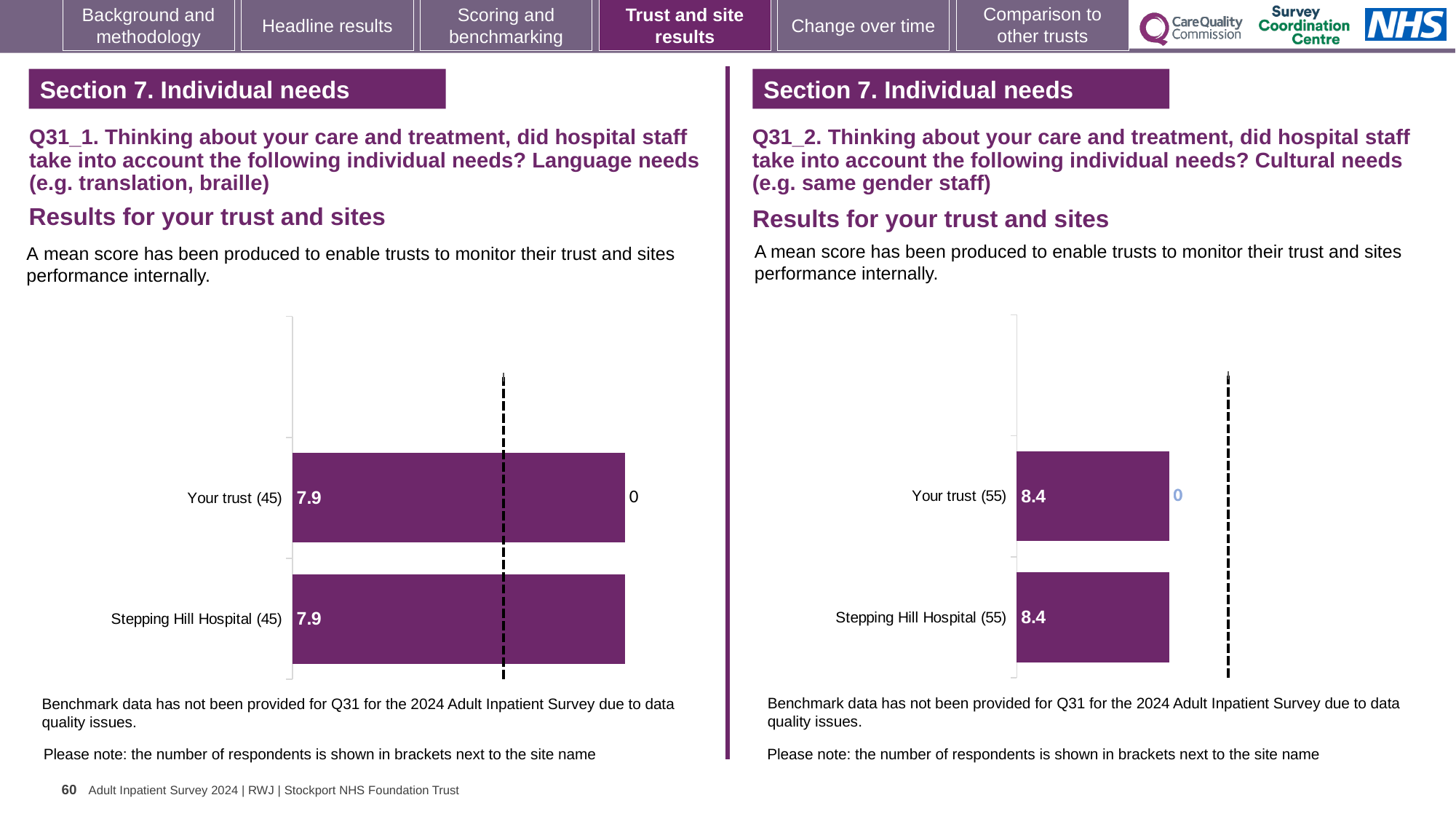
What kind of chart is used for the Q31_2 Cultural needs results on the right? Bar chart In the Q31_2 Cultural needs chart on the right, how many respondents are shown in brackets next to Stepping Hill Hospital? 55 In the Q31_1 Language needs chart on the left, what is the difference between the scores for Your trust and Stepping Hill Hospital? 0 In the Q31_1 Language needs chart on the left, how many respondents are shown in brackets next to Your trust? 45 In the Q31_2 Cultural needs chart on the right, what is the difference between the scores for Your trust and Stepping Hill Hospital? 0 In the Q31_2 Cultural needs chart on the right, what is the mean score for Stepping Hill Hospital? 8.4 In the Q31_1 Language needs chart on the left, what is the mean score for Your trust? 7.9 How many categories are shown in the Q31_2 Cultural needs chart on the right? 2 How many bars are plotted in the Q31_1 Language needs chart on the left? 2 What kind of chart is used for the Q31_1 Language needs results on the left? Bar chart In the Q31_2 Cultural needs chart on the right, what is the mean score for Your trust? 8.4 In the Q31_1 Language needs chart on the left, what is the mean score for Stepping Hill Hospital? 7.9